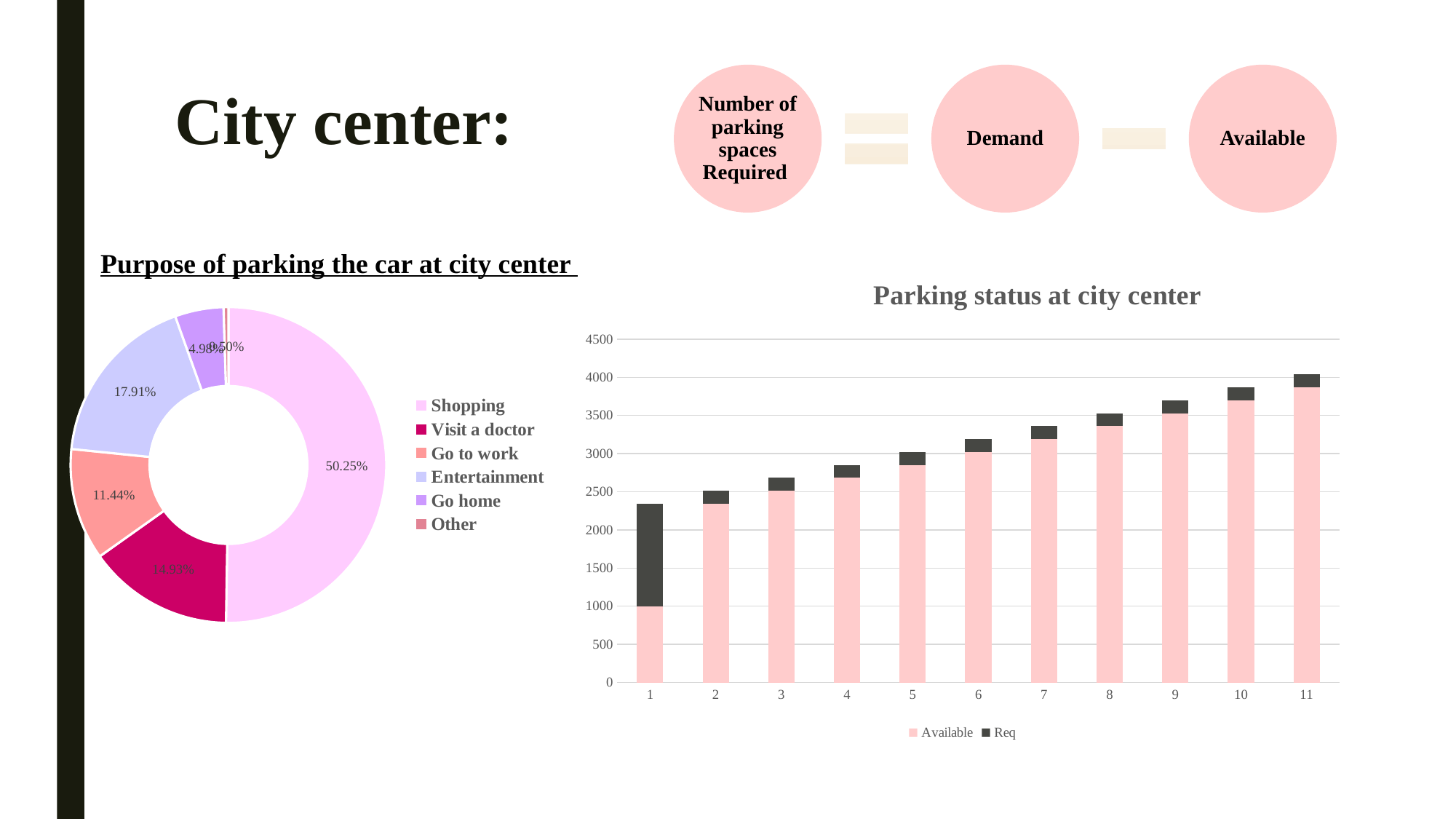
In the 'Purpose of parking the car at city center' chart, what share is Visit a doctor? 14.93% In the 'Purpose of parking the car at city center' chart, which is larger: Go to work or Entertainment? Entertainment What kind of chart is 'Parking status at city center'? Stacked bar chart In the 'Purpose of parking the car at city center' chart, which purpose has the largest share? Shopping How many categories does the 'Purpose of parking the car at city center' chart show? 6 In the 'Purpose of parking the car at city center' chart, what is the difference between the Shopping and Visit a doctor shares? 35.32% In the 'Parking status at city center' chart, do the total bar heights rise or fall from category 1 to category 11? Rise How many series does the legend of the 'Parking status at city center' chart list? 2 In the 'Purpose of parking the car at city center' chart, which purpose has the smallest share? Other In the 'Purpose of parking the car at city center' chart, what share is Entertainment? 17.91% In the 'Purpose of parking the car at city center' chart, what share is Shopping? 50.25% In the 'Parking status at city center' chart, is the Available value for category 11 greater or less than 3500? greater